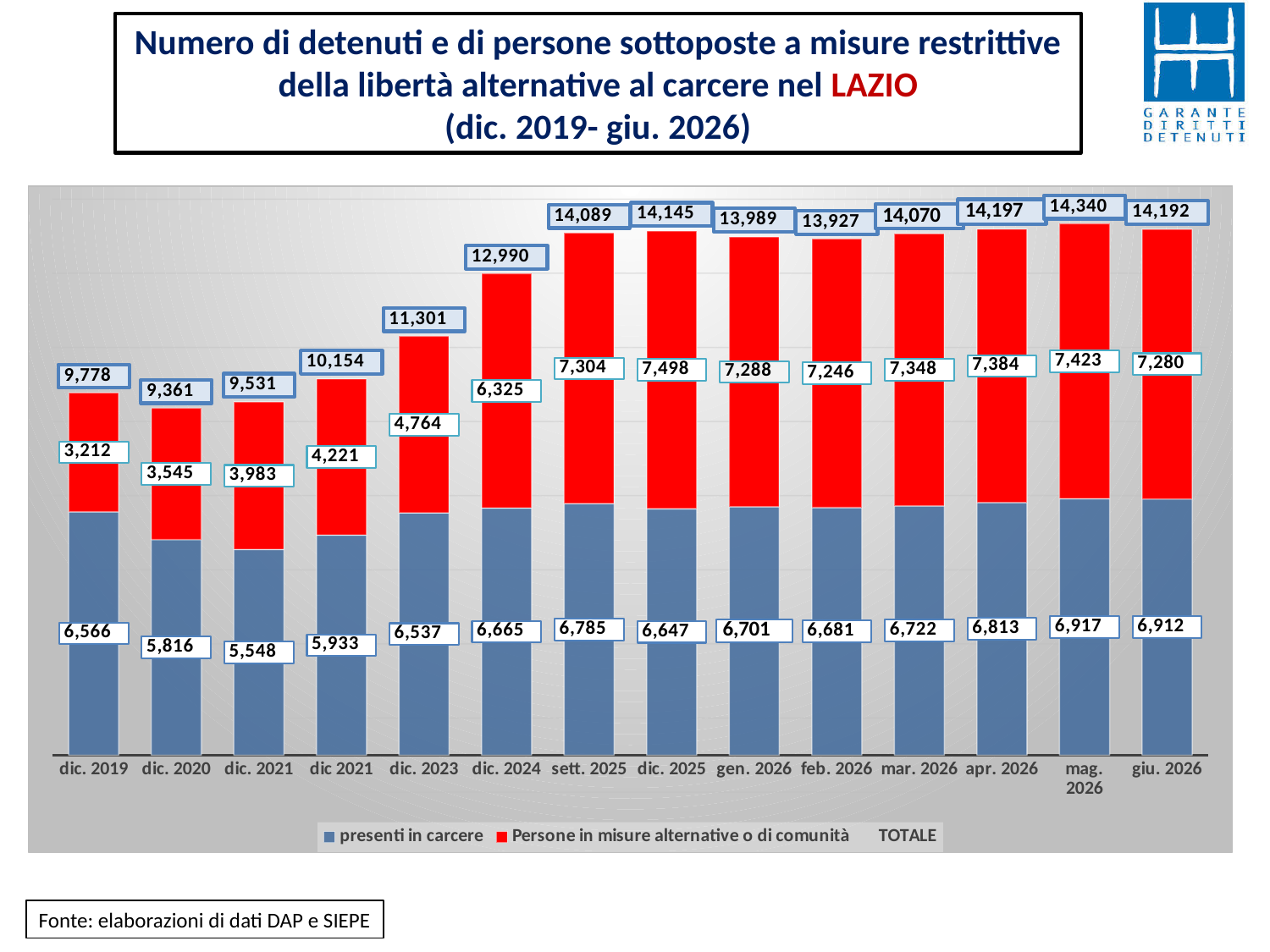
Which is larger in dic. 2024: 'presenti in carcere' or 'Persone in misure alternative o di comunità'? presenti in carcere What is the value for 'Persone in misure alternative o di comunità' in dic. 2025? 7,498 What is the TOTALE value shown for giu. 2026? 14,192 What is the difference between the TOTALE for giu. 2026 and the TOTALE for dic. 2019? 4,414 What kind of chart is shown on the slide? stacked bar chart How many entries does the legend list? 3 How many periods (bars) are shown on the x axis? 14 What is the value for 'presenti in carcere' in dic. 2019? 6,566 Which period has the highest value for 'Persone in misure alternative o di comunità'? dic. 2025 In giu. 2026, how much larger is 'Persone in misure alternative o di comunità' than 'presenti in carcere'? 368 Which period has the lowest TOTALE value? dic. 2020 Which period has the highest TOTALE value? mag. 2026